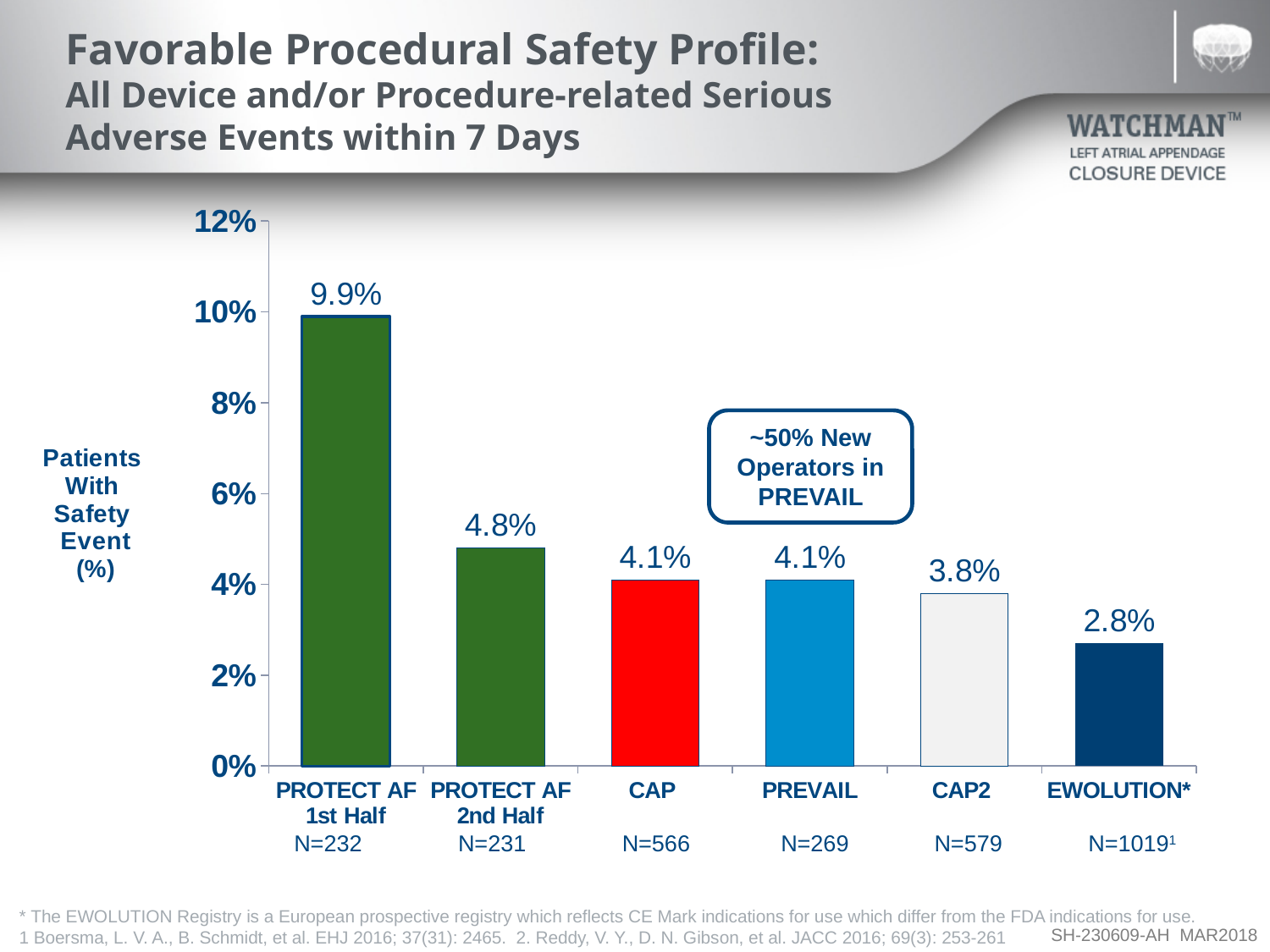
What is the value for EWOLUTION*? 2.8% What is the label of the y axis? Patients With Safety Event (%) What is the value for PROTECT AF 1st Half? 9.9% Which category has the lowest value? EWOLUTION* Is the value for PROTECT AF 1st Half greater or less than 8%? greater What is the difference between the values for PROTECT AF 1st Half and PROTECT AF 2nd Half? 5.1% Which is larger, the value for PROTECT AF 2nd Half or the value for CAP2? PROTECT AF 2nd Half What kind of chart is shown on the slide? bar chart How many categories are shown on the x axis? 6 What is the value for CAP2? 3.8% Which category has the highest value? PROTECT AF 1st Half Do the values rise or fall from left to right along the x axis? fall